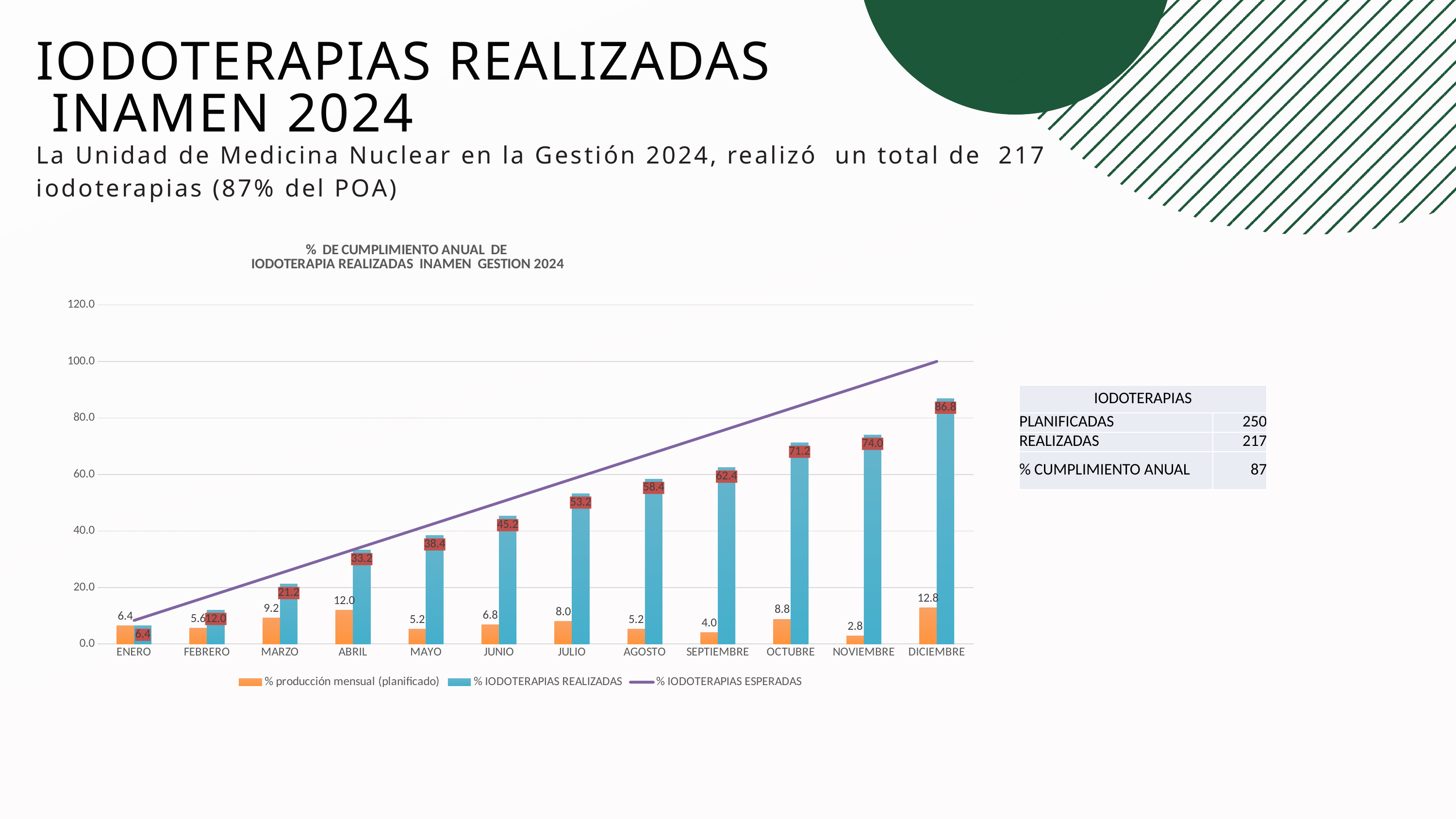
How many series does the chart legend list? 3 How many months are shown on the x axis of the chart? 12 Which is larger, the % producción mensual (planificado) value for MARZO or for OCTUBRE? MARZO Which month has the lowest value for % producción mensual (planificado)? NOVIEMBRE What is the value of % IODOTERAPIAS REALIZADAS for JULIO? 53.2 What is the value of % IODOTERAPIAS REALIZADAS for DICIEMBRE? 86.8 Which month has the highest value for % producción mensual (planificado)? DICIEMBRE Is the % IODOTERAPIAS REALIZADAS value for AGOSTO greater or less than 60.0? less Do the % IODOTERAPIAS REALIZADAS values rise or fall from ENERO to DICIEMBRE? rise What is the value of % producción mensual (planificado) for ABRIL? 12.0 What is the difference between the % IODOTERAPIAS REALIZADAS values for NOVIEMBRE and OCTUBRE? 2.8 What colour are the bars for % IODOTERAPIAS REALIZADAS? blue